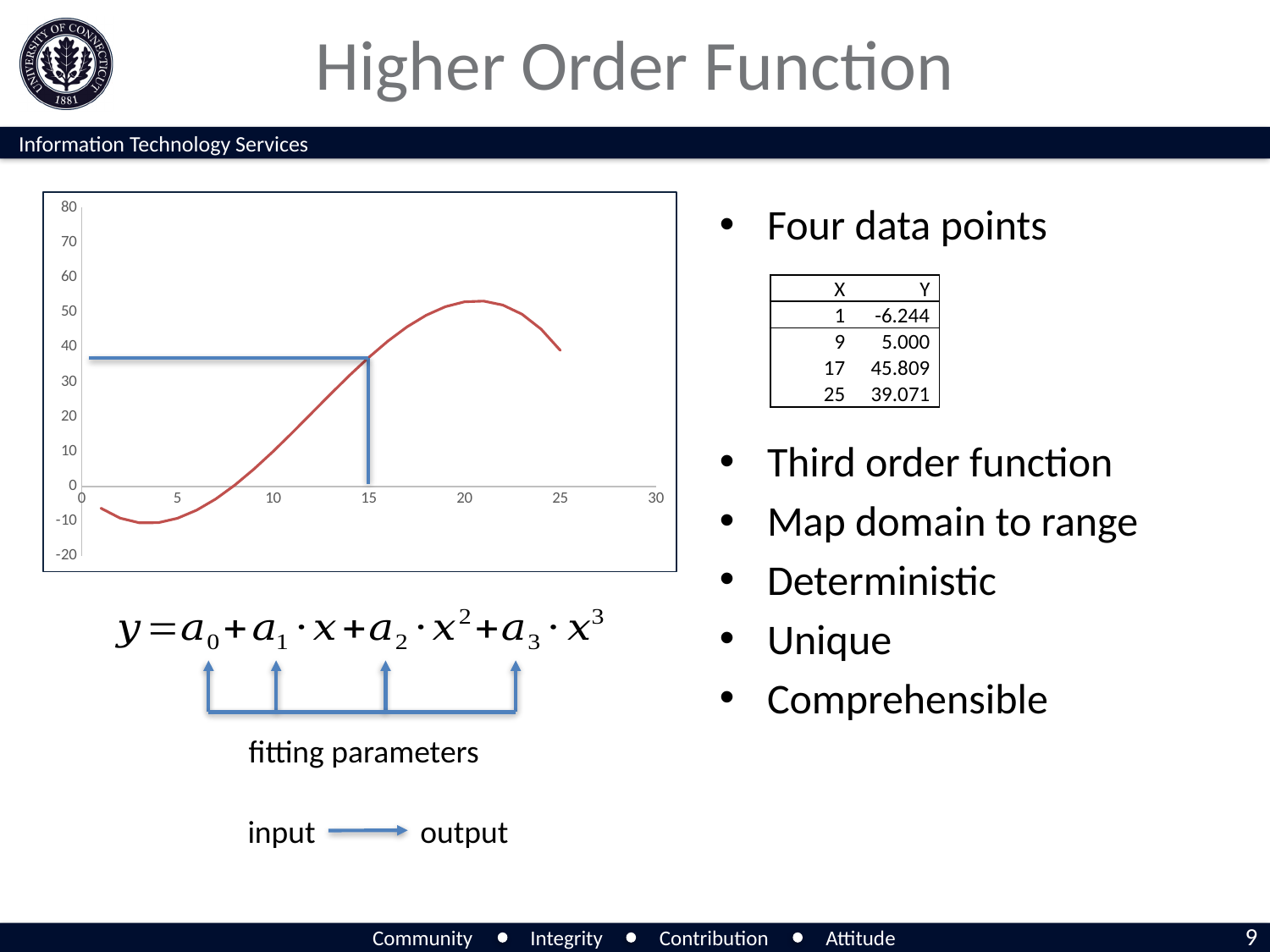
How many lines (series) are plotted on the chart? 1 Is the peak value of the curve greater or less than 50? greater Is the value of the curve at x = 5 greater or less than 0? less Is the value of the curve at x = 15 greater or less than 40? less What kind of chart is shown on the slide? line chart Does the curve rise or fall between x = 5 and x = 15? rise Which is larger: the value of the curve at x = 15 or at x = 5? x = 15 What is the highest value shown on the chart's vertical axis? 80 What is the lowest value shown on the chart's vertical axis? -20 Does the curve rise or fall between x = 20 and x = 25? fall